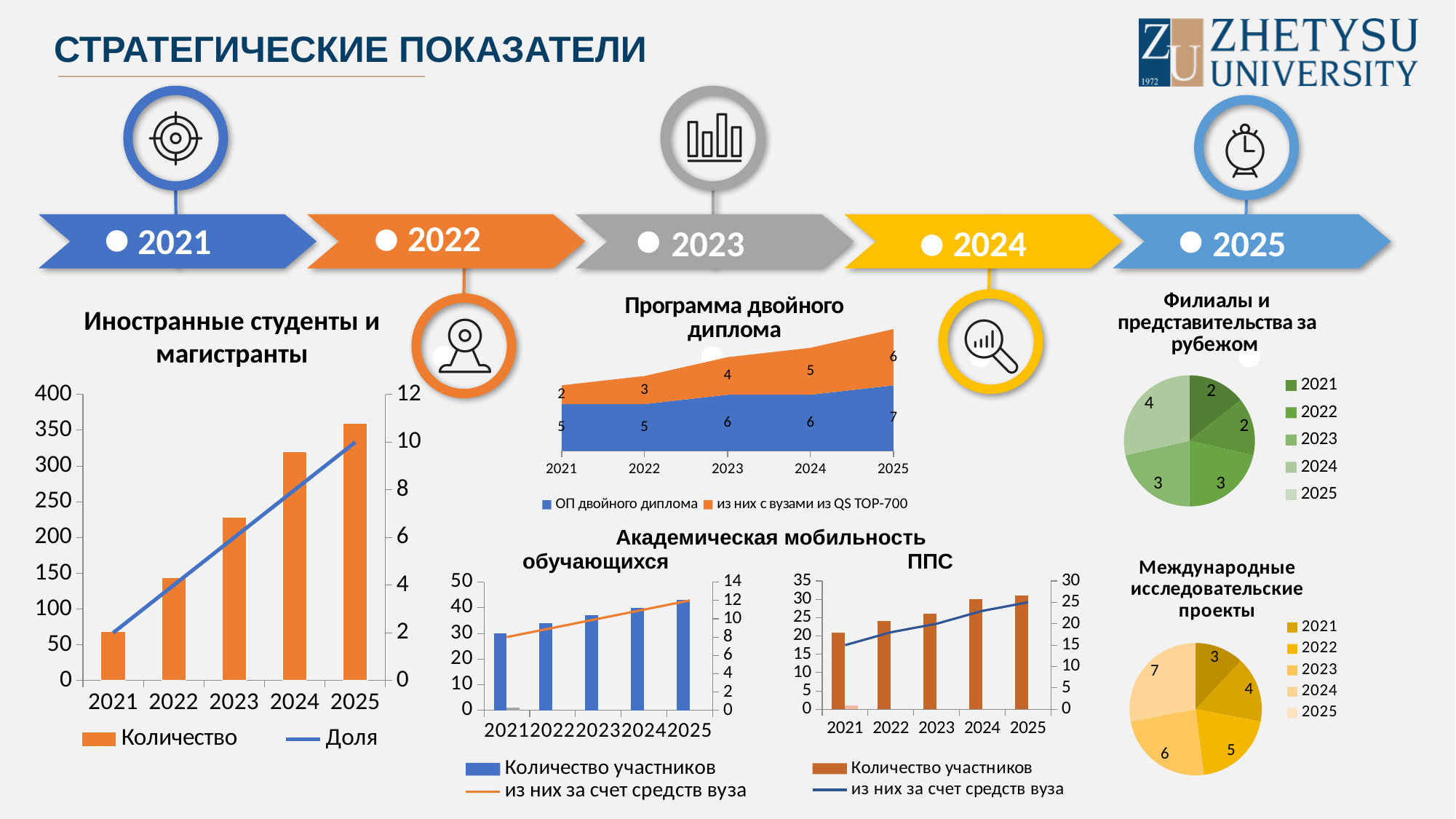
In the 'Международные исследовательские проекты' pie chart, which year has the smallest slice? 2021 In the 'Иностранные студенты и магистранты' chart, do the 'Количество' bars rise or fall from 2021 to 2025? rise In the 'Программа двойного диплома' chart, what is the combined total of the two series for 2023? 10 In the 'Иностранные студенты и магистранты' chart, is the 'Количество' value for 2024 greater or less than 300? greater In the 'Международные исследовательские проекты' pie chart, what is the difference between the 2025 and 2021 values? 4 In the 'Международные исследовательские проекты' pie chart, what share of the total does 2025 represent? 28% In the 'Международные исследовательские проекты' pie chart, which year has the largest slice? 2025 In the 'Филиалы и представительства за рубежом' pie chart, which year has the largest slice? 2025 In the 'Академическая мобильность ППС' chart, which year has the larger 'Количество участников' bar, 2021 or 2025? 2025 In the 'Программа двойного диплома' chart, what is the value of 'ОП двойного диплома' for 2025? 7 How many series does the legend of the 'Программа двойного диплома' chart list? 2 In the 'Программа двойного диплома' chart, what is the value of 'из них с вузами из QS TOP-700' for 2024? 5